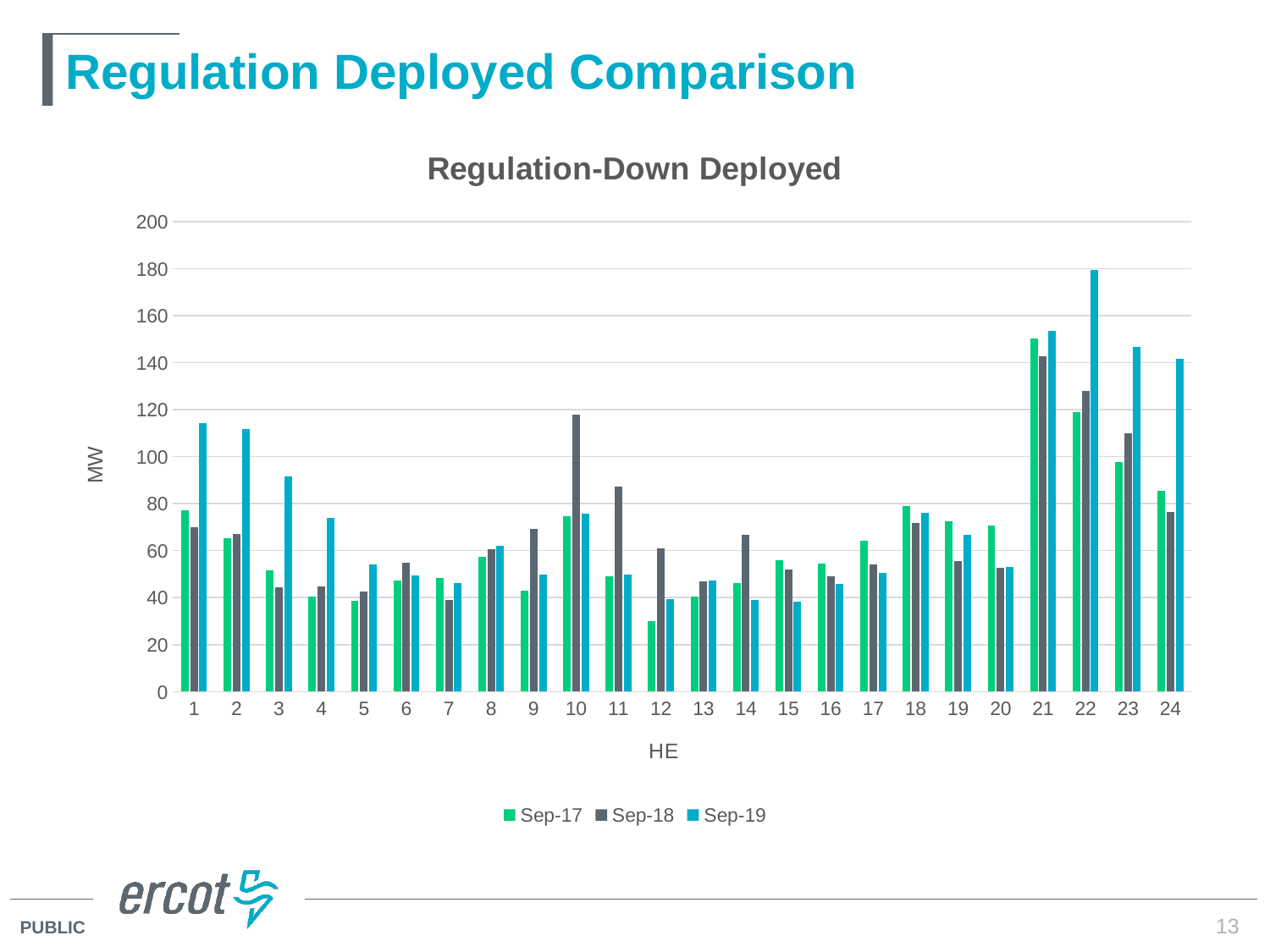
What is the label on the vertical axis? MW How many hour-ending (HE) categories are shown on the x axis? 24 What is the title of the chart? Regulation-Down Deployed What kind of chart is shown on the slide? bar chart At which HE is the Sep-18 value highest? 10 At HE 10, which is larger: the Sep-17 value or the Sep-18 value? Sep-18 Is the Sep-19 value at HE 22 greater or less than 160? greater How many series does the legend list? 3 At HE 1, which is larger: the Sep-17 value or the Sep-19 value? Sep-19 At which HE is the Sep-17 value lowest? 12 Which series has the highest bar in the whole chart, and at which HE? Sep-19 at HE 22